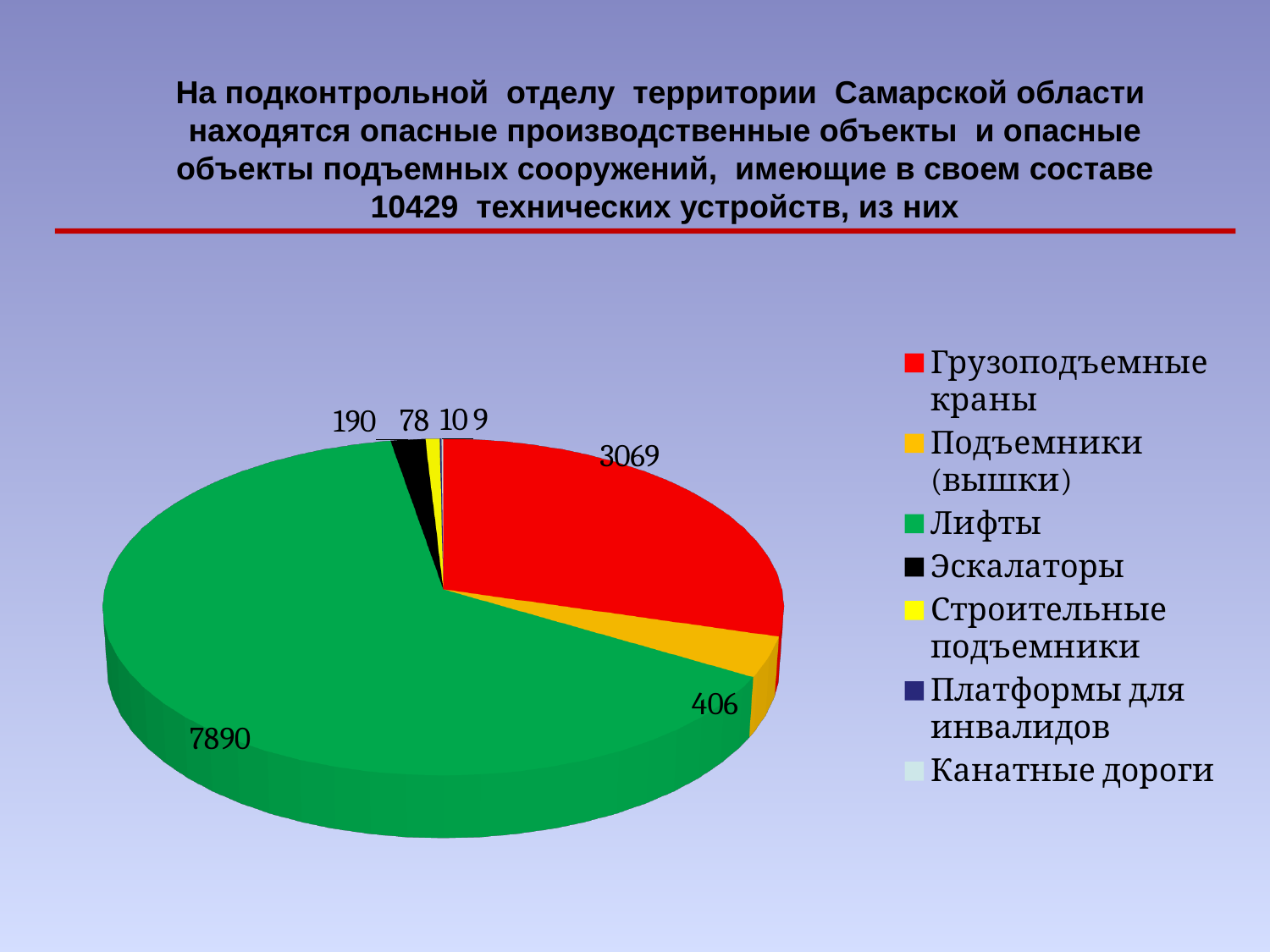
What is the value for Эскалаторы in the pie chart? 190 What is the value for Лифты in the pie chart? 7890 What is the value for Грузоподъемные краны in the pie chart? 3069 What is the difference between the values for Лифты and Грузоподъемные краны in the pie chart? 4821 What is the difference between the values for Подъемники (вышки) and Эскалаторы in the pie chart? 216 What is the value for Подъемники (вышки) in the pie chart? 406 What kind of chart is shown on the slide? pie chart What colour is the slice for Лифты in the pie chart? green Which is larger in the pie chart: Грузоподъемные краны or Подъемники (вышки)? Грузоподъемные краны What is the value for Строительные подъемники in the pie chart? 78 How many categories does the legend of the pie chart list? 7 Which category has the largest slice in the pie chart? Лифты